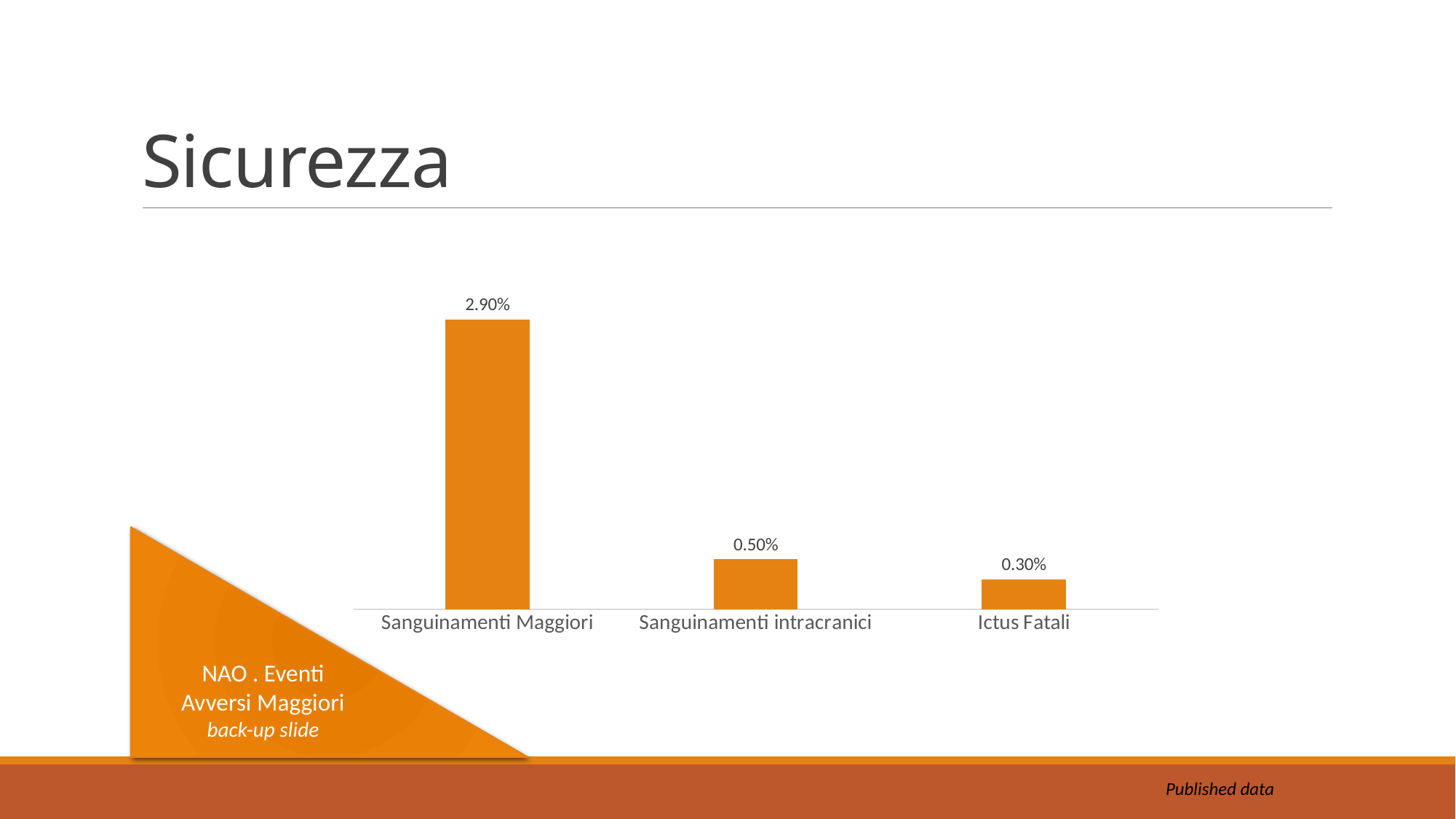
Do the values rise or fall from left to right across the categories? Fall How many categories are shown in the chart? 3 What is the value for Sanguinamenti Maggiori? 2.90% What is the title of the slide containing the chart? Sicurezza What is the value for Ictus Fatali? 0.30% What is the difference between the values for Sanguinamenti Maggiori and Sanguinamenti intracranici? 2.40% Which is larger, the value for Sanguinamenti intracranici or the value for Ictus Fatali? Sanguinamenti intracranici Which category has the highest value? Sanguinamenti Maggiori Which category has the lowest value? Ictus Fatali What is the difference between the values for Sanguinamenti intracranici and Ictus Fatali? 0.20% What kind of chart is shown on the slide? Bar chart What is the value for Sanguinamenti intracranici? 0.50%